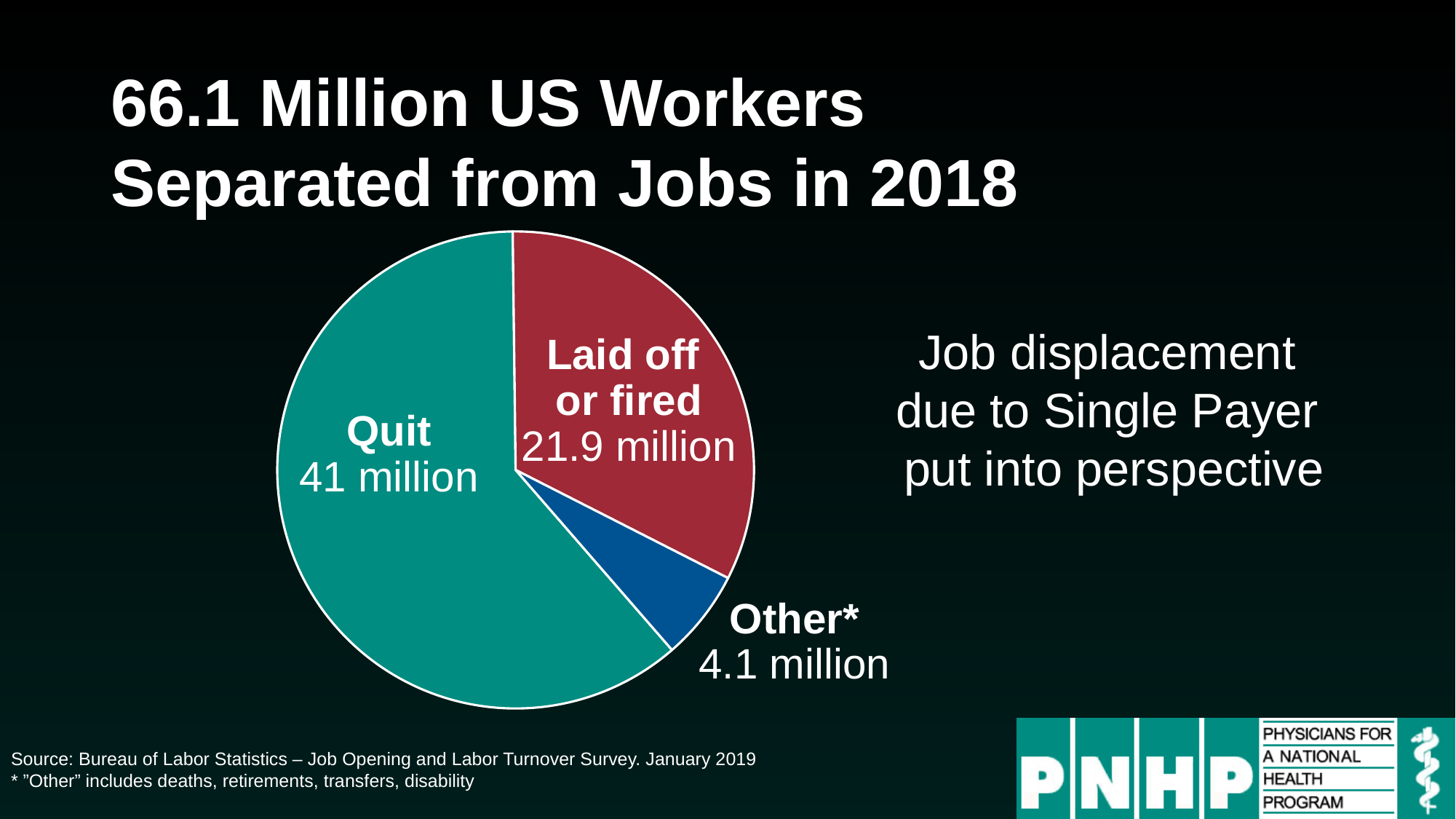
How many slices does the pie chart have? 3 What is the difference between the Quit value and the Laid off or fired value? 19.1 million Which category has the largest slice of the pie? Quit What is the difference between the Laid off or fired value and the Other* value? 17.8 million Which category has the smallest slice of the pie? Other* Which is larger, the Laid off or fired slice or the Other* slice? Laid off or fired What is the value for the Quit slice? 41 million What type of chart is shown on the slide? Pie chart What is the value for the Other* slice? 4.1 million What is the value for the Laid off or fired slice? 21.9 million What colour is the Quit slice of the pie chart? Teal What is the title of the slide containing the pie chart? 66.1 Million US Workers Separated from Jobs in 2018